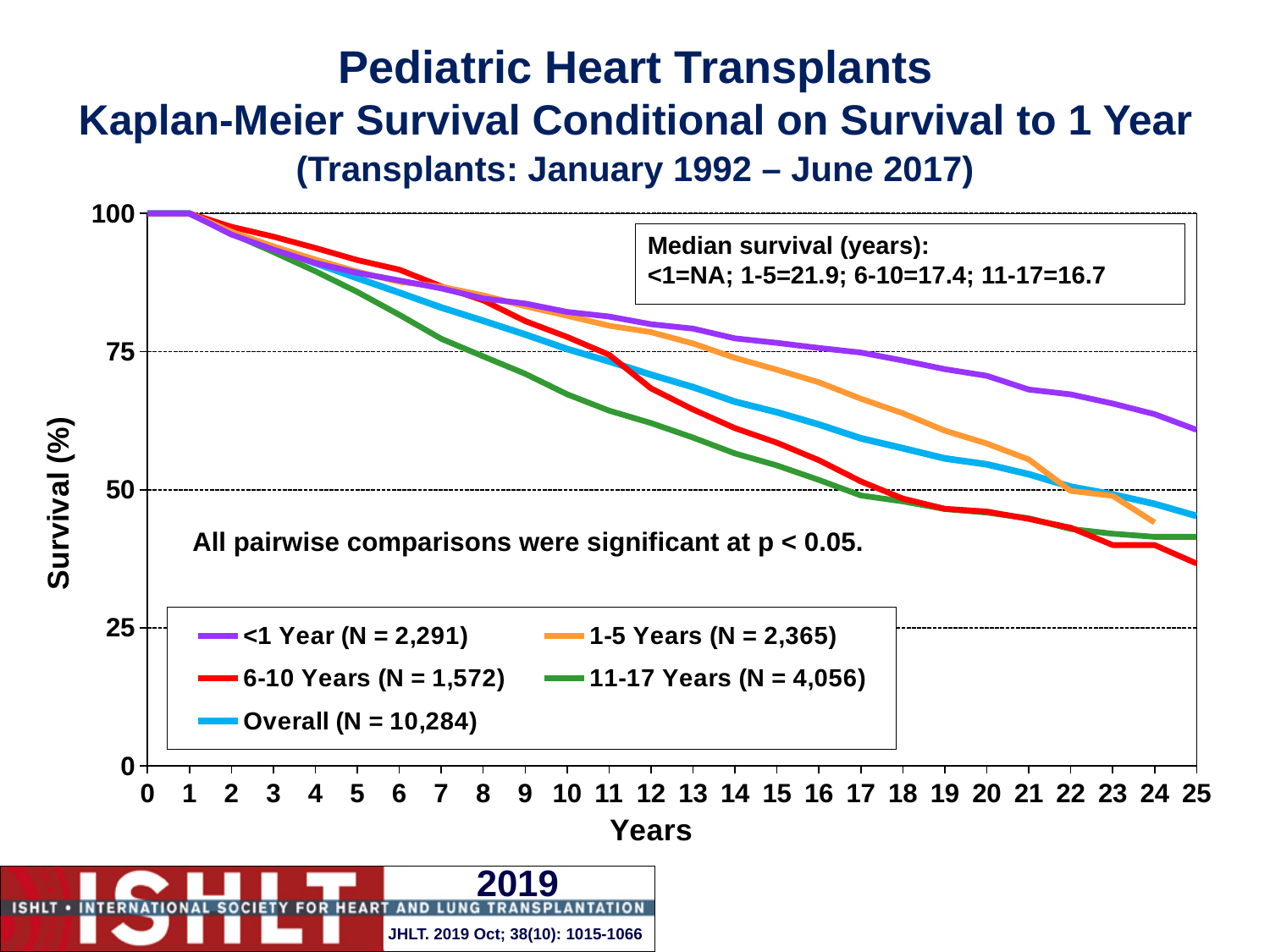
Which group has the highest survival at 25 years? <1 Year What is the difference in median survival (years) between the 1-5 Years group and the 11-17 Years group? 5.2 Which group has the lowest survival at 25 years? 6-10 Years At 20 years, which has higher survival: the 1-5 Years group or the 11-17 Years group? 1-5 Years What is the median survival in years for the 1-5 Years group? 21.9 What is the N for the Overall series in the legend? 10,284 Do the survival curves rise or fall as years increase? fall How many series does the legend list? 5 Is the survival for the 11-17 Years group at 10 years greater or less than 75? less What kind of chart is shown on the slide? line chart Is the survival for the <1 Year group at 25 years greater or less than 50? greater What is the median survival in years for the 11-17 Years group? 16.7